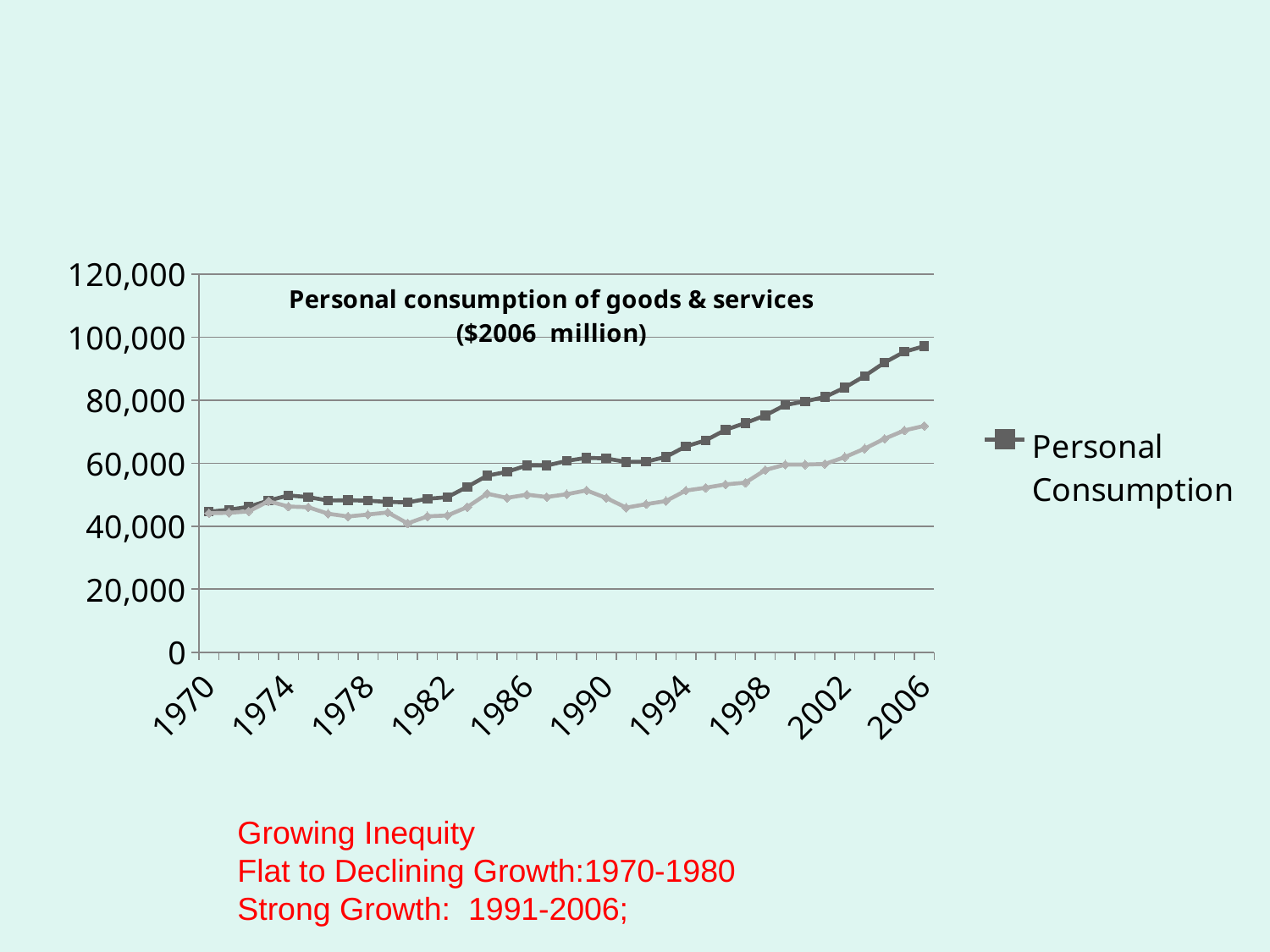
Which is larger for the Personal Consumption line: the value in 1970 or the value in 2006? 2006 What is the name of the series listed in the legend? Personal Consumption Is the value of the Personal Consumption line in 2004 greater or less than 80,000? greater Is the value of the lighter line in 2006 greater or less than 80,000? less Is the value of the Personal Consumption line in 2006 greater or less than 80,000? greater How many series does the legend list? 1 What is the title of the chart? Personal consumption of goods & services ($2006 million) What kind of chart is shown on the slide? Line chart Does the Personal Consumption line generally rise or fall from 1970 to 2006? Rise How many year labels are shown on the x axis? 10